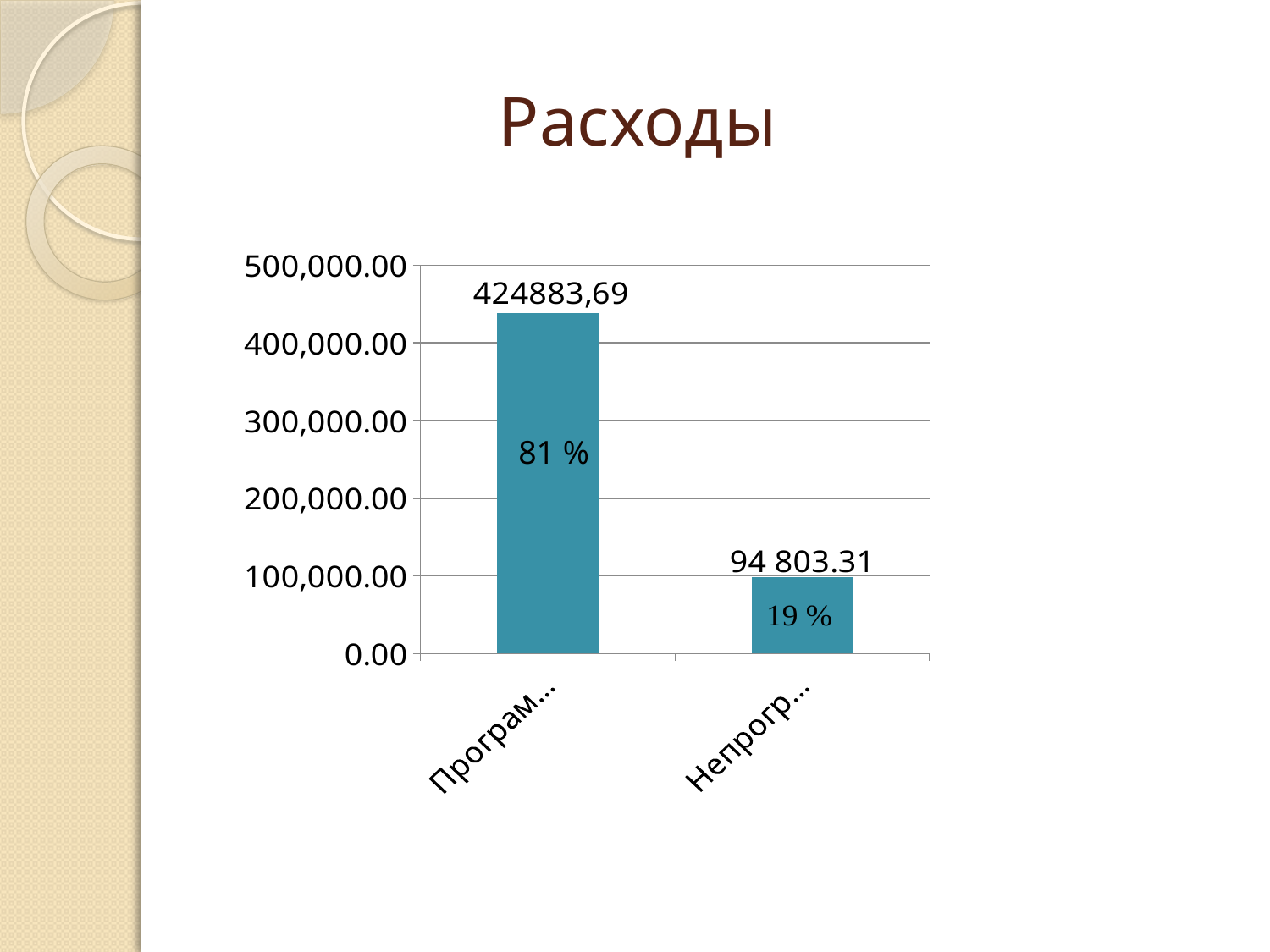
How many bars does the chart have? 2 What percentage is printed inside the right bar (Непрогр…)? 19 % What is the title of the chart? Расходы Which bar is the lowest? the right bar (Непрогр…) What value is printed above the right bar (Непрогр…)? 94 803.31 Which bar is the highest? the left bar (Програм…) What percentage is printed inside the left bar (Програм…)? 81 % Which is larger, the left bar (Програм…) or the right bar (Непрогр…)? the left bar (Програм…) What value is printed above the left bar (Програм…)? 424883,69 Do the bar values rise or fall from left to right? fall Is the value for the left bar (Програм…) greater or less than 400,000.00? greater What kind of chart is shown on the slide? bar chart